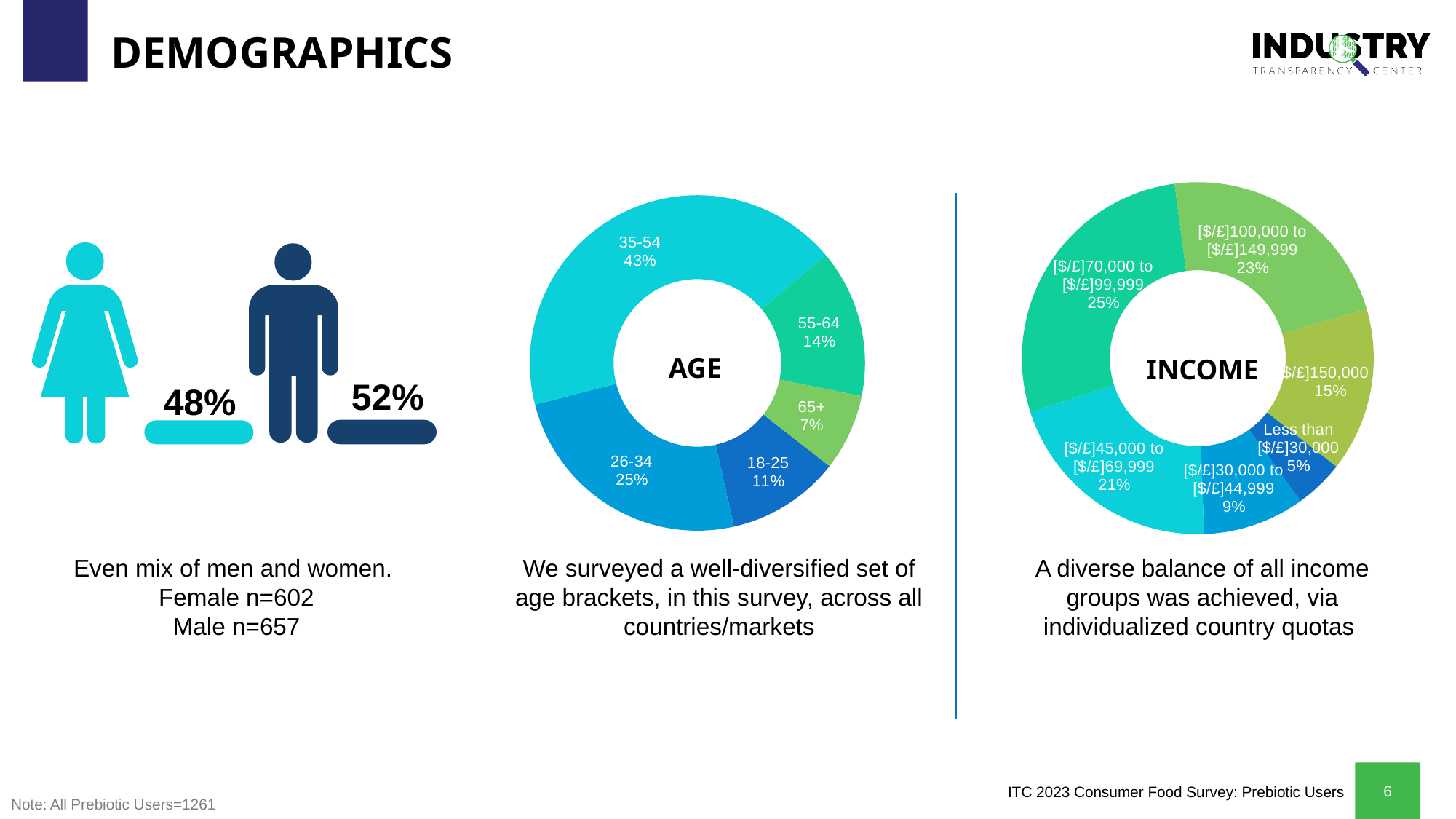
In the INCOME chart, what share of respondents earn [$/£]70,000 to [$/£]99,999? 25% In the AGE chart, what is the difference in percentage points between the 26-34 and 18-25 brackets? 14 What kind of chart is the AGE chart? Doughnut (pie) chart In the INCOME chart, what is the difference in percentage points between the [$/£]150,000+ group and the [$/£]30,000 to [$/£]44,999 group? 6 In the INCOME chart, which is larger: the [$/£]100,000 to [$/£]149,999 group or the [$/£]45,000 to [$/£]69,999 group? [$/£]100,000 to [$/£]149,999 In the AGE chart, which age bracket has the largest share? 35-54 In the AGE chart, what is the combined share of the 55-64 and 65+ brackets? 21% In the INCOME chart, how many income groups are shown? 6 In the AGE chart, which age bracket has the smallest share? 65+ In the INCOME chart, which income group has the smallest share? Less than [$/£]30,000 In the AGE chart, what share of respondents are aged 35-54? 43% In the AGE chart, how many age brackets are shown? 5